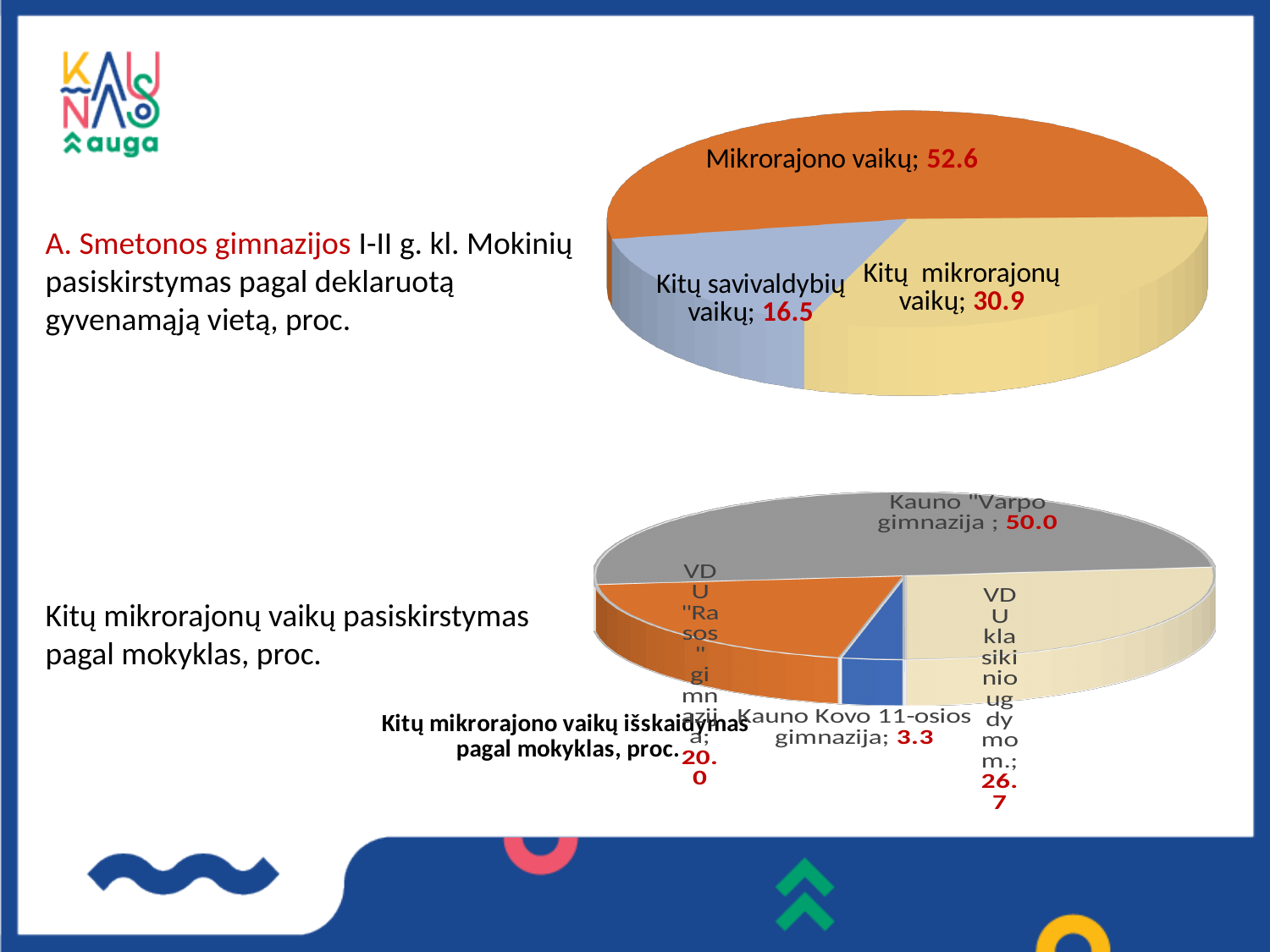
In the bottom pie chart, which is larger: VDU klasikinio ugdymo m. or VDU "Rasos" gimnazija? VDU klasikinio ugdymo m. In the top pie chart, which category has the smallest share? Kitų savivaldybių vaikų In the bottom pie chart, which school has the smallest share? Kauno Kovo 11-osios gimnazija In the bottom pie chart, what is the value for Kauno Kovo 11-osios gimnazija? 3.3 How many slices does the top pie chart have? 3 In the top pie chart, what is the difference between Mikrorajono vaikų and Kitų mikrorajonų vaikų? 21.7 In the top pie chart, what is the value for Kitų savivaldybių vaikų? 16.5 In the top pie chart, what is the value for Mikrorajono vaikų? 52.6 In the top pie chart, which category has the largest share? Mikrorajono vaikų What type of chart is the top chart on the slide? Pie chart How many slices does the bottom pie chart have? 4 In the bottom pie chart, what is the value for Kauno "Varpo" gimnazija? 50.0